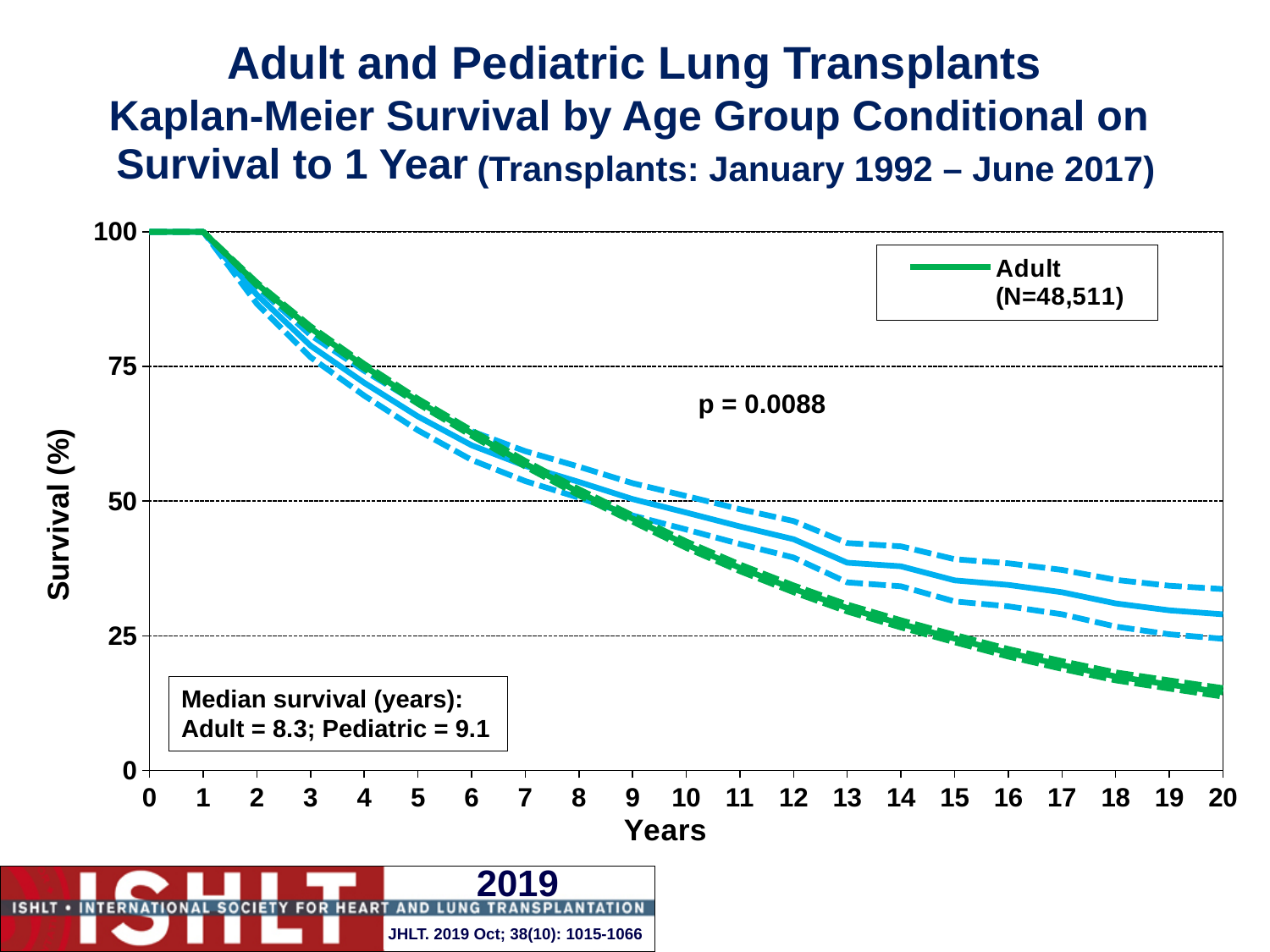
What is the median survival in years for the Pediatric group? 9.1 What is the difference between the Pediatric and Adult median survival in years? 0.8 What p-value is shown on the chart? p = 0.0088 What is the N shown for the Adult group in the legend? N=48,511 Is the Adult survival at 10 years greater or less than 50? less What is the median survival in years for the Adult group? 8.3 How many series does the legend list? 1 Which group has the longer median survival, Adult or Pediatric? Pediatric Is the Adult survival at 5 years greater or less than 50? greater Do the survival curves rise or fall as years increase along the x axis? fall What kind of chart is shown on the slide? line chart Is the Adult survival at 20 years greater or less than 25? less